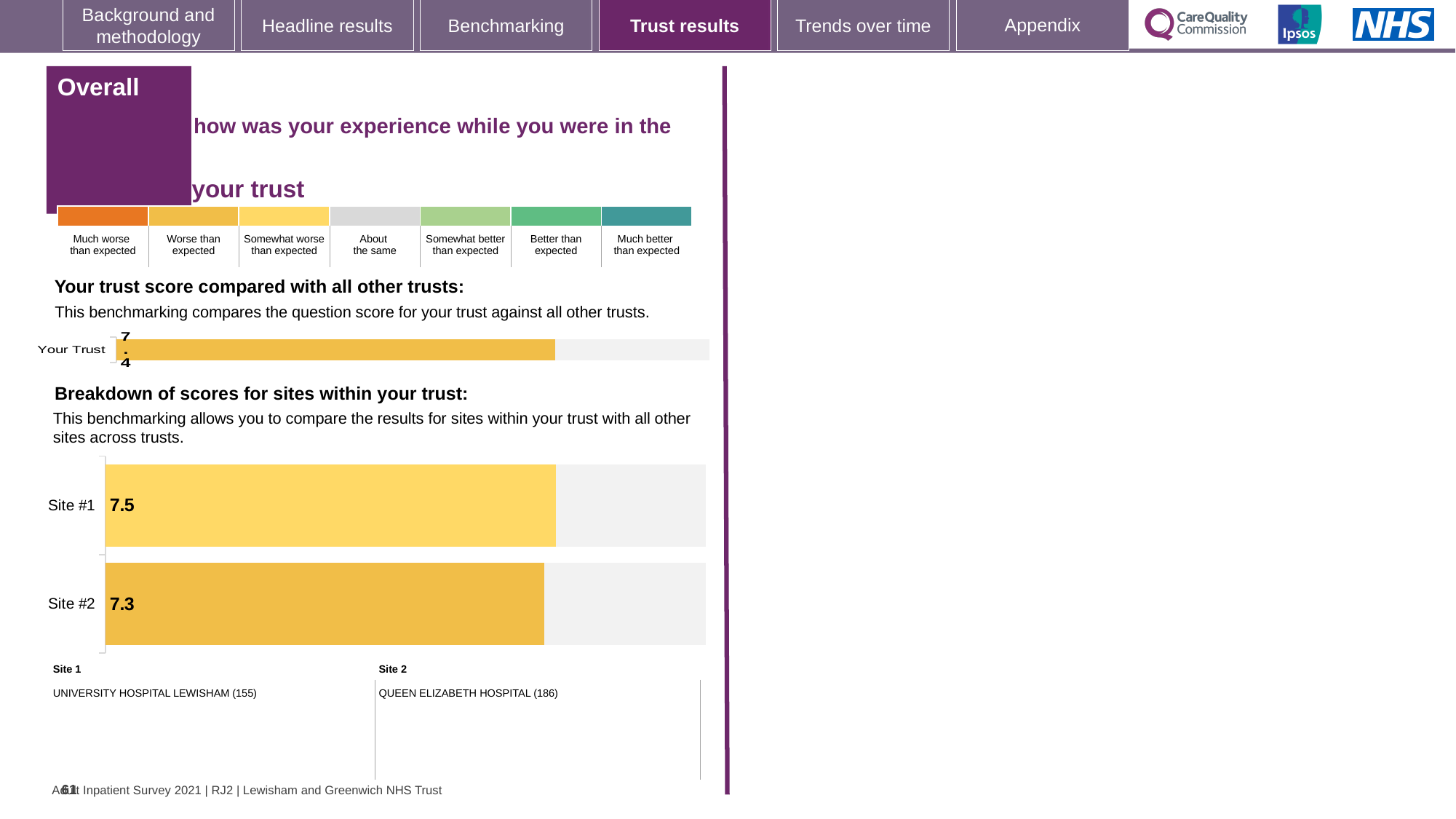
In the 'Your trust score compared with all other trusts' chart, what is the score for Your Trust? 7.4 In the 'Breakdown of scores for sites within your trust' chart, what is the score for Site #1? 7.5 In the 'Breakdown of scores for sites within your trust' chart, how many sites are plotted? 2 In the 'Breakdown of scores for sites within your trust' chart, what is the difference between the scores for Site #1 and Site #2? 0.2 In the 'Breakdown of scores for sites within your trust' chart, which hospital is Site 2? QUEEN ELIZABETH HOSPITAL (186) In the 'Breakdown of scores for sites within your trust' chart, which site has the highest score? Site #1 What kind of chart is the 'Breakdown of scores for sites within your trust' chart? bar chart In the 'Your trust score compared with all other trusts' chart, how many bars are plotted? 1 In the 'Breakdown of scores for sites within your trust' chart, which site has the lowest score? Site #2 In the 'Breakdown of scores for sites within your trust' chart, which hospital is Site 1? UNIVERSITY HOSPITAL LEWISHAM (155) In the 'Breakdown of scores for sites within your trust' chart, what is the score for Site #2? 7.3 In the 'Breakdown of scores for sites within your trust' chart, is the score for Site #1 larger or smaller than the score for Site #2? larger